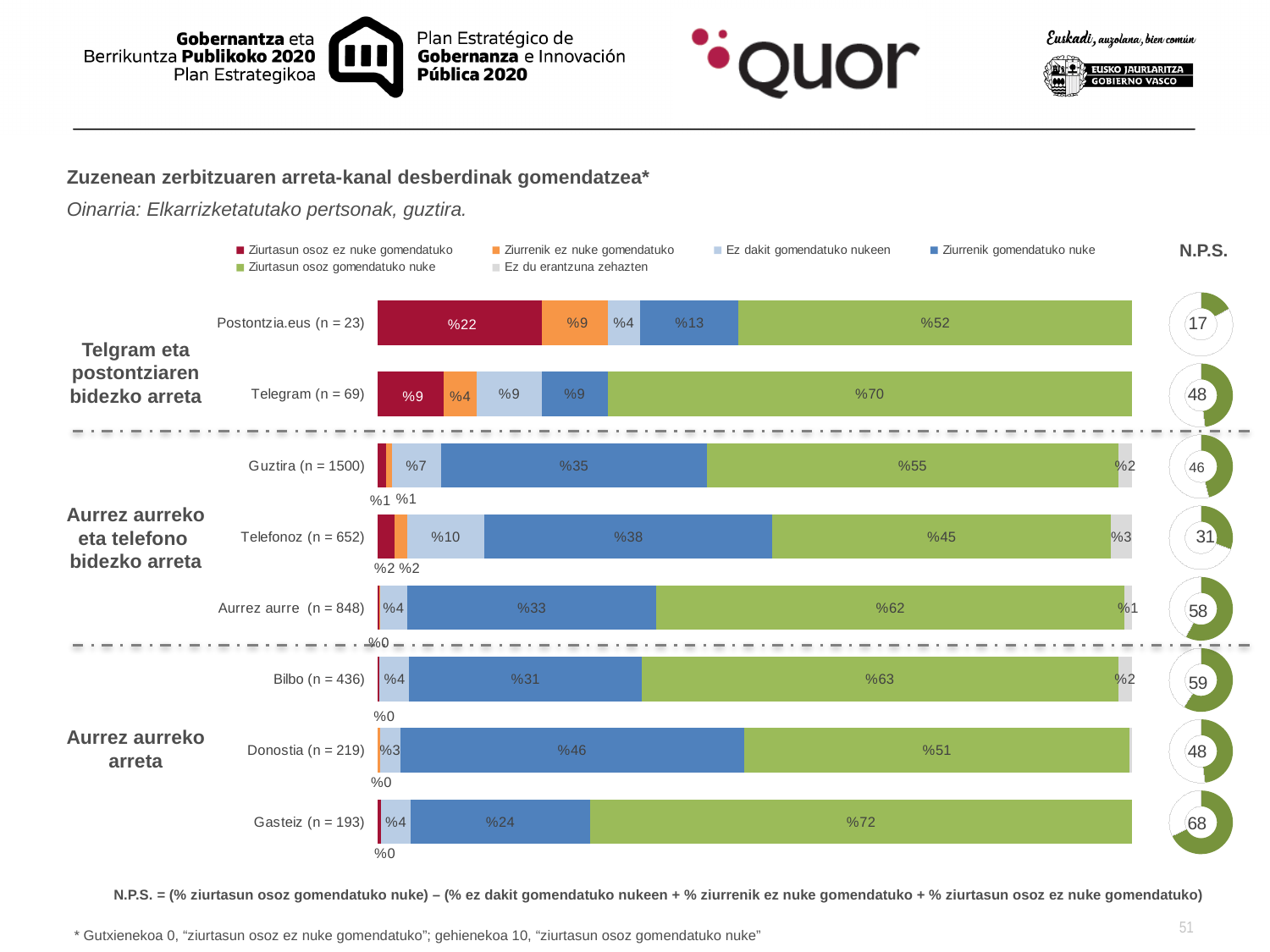
Which category has the lowest N.P.S. value? Postontzia.eus (n = 23) What is the value of "Ziurtasun osoz ez nuke gomendatuko" for Postontzia.eus (n = 23)? %22 What kind of chart is used to show the recommendation responses? Stacked bar chart How many categories (bars) are shown in the chart? 8 Which has a larger "Ziurrenik gomendatuko nuke" value, Donostia (n = 219) or Telefonoz (n = 652)? Donostia (n = 219) Which category has the highest value for "Ziurtasun osoz gomendatuko nuke"? Gasteiz (n = 193) What is the N.P.S. value for Gasteiz (n = 193)? 68 What is the difference in "Ziurtasun osoz gomendatuko nuke" between Gasteiz (n = 193) and Postontzia.eus (n = 23)? 20 percentage points What is the value of "Ez dakit gomendatuko nukeen" for Telefonoz (n = 652)? %10 Which category has the lowest value for "Ziurtasun osoz gomendatuko nuke"? Telefonoz (n = 652) How many series does the legend list? 6 What is the value of "Ziurtasun osoz gomendatuko nuke" for Telegram (n = 69)? %70